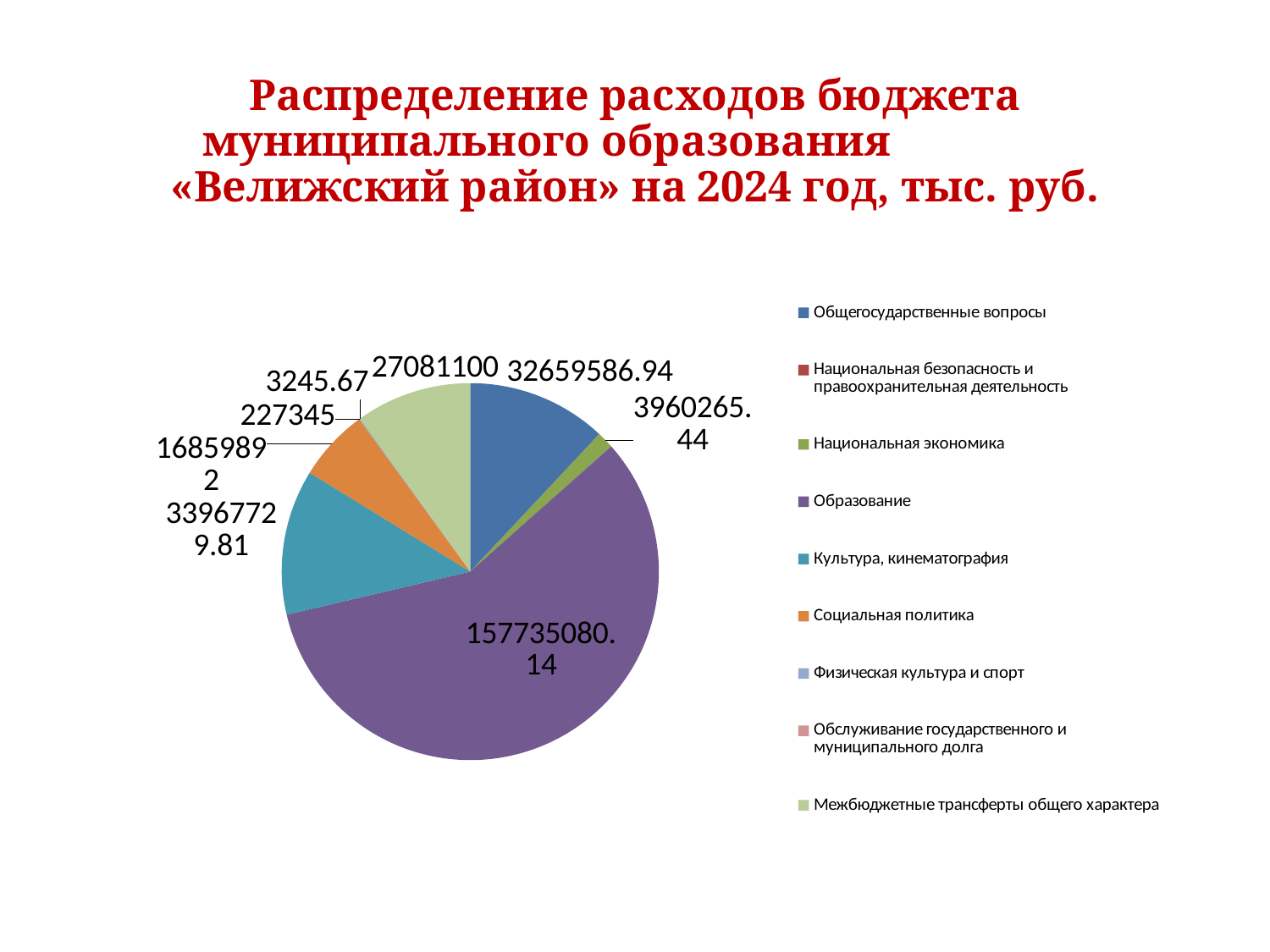
What is the value for Общегосударственные вопросы? 32659586.94 What is the value for Межбюджетные трансферты общего характера? 27081100 Which is larger: Культура, кинематография or Социальная политика? Культура, кинематография What type of chart is shown on the slide? pie chart Which category has the largest slice of the pie? Образование Which is larger: Общегосударственные вопросы or Межбюджетные трансферты общего характера? Общегосударственные вопросы What is the value for Образование? 157735080.14 What is the value for Обслуживание государственного и муниципального долга? 3245.67 What colour is the slice for Образование? purple What is the value for Физическая культура и спорт? 227345 What is the difference between the values for Общегосударственные вопросы and Межбюджетные трансферты общего характера? 5578486.94 How many categories does the legend of the pie chart list? 9